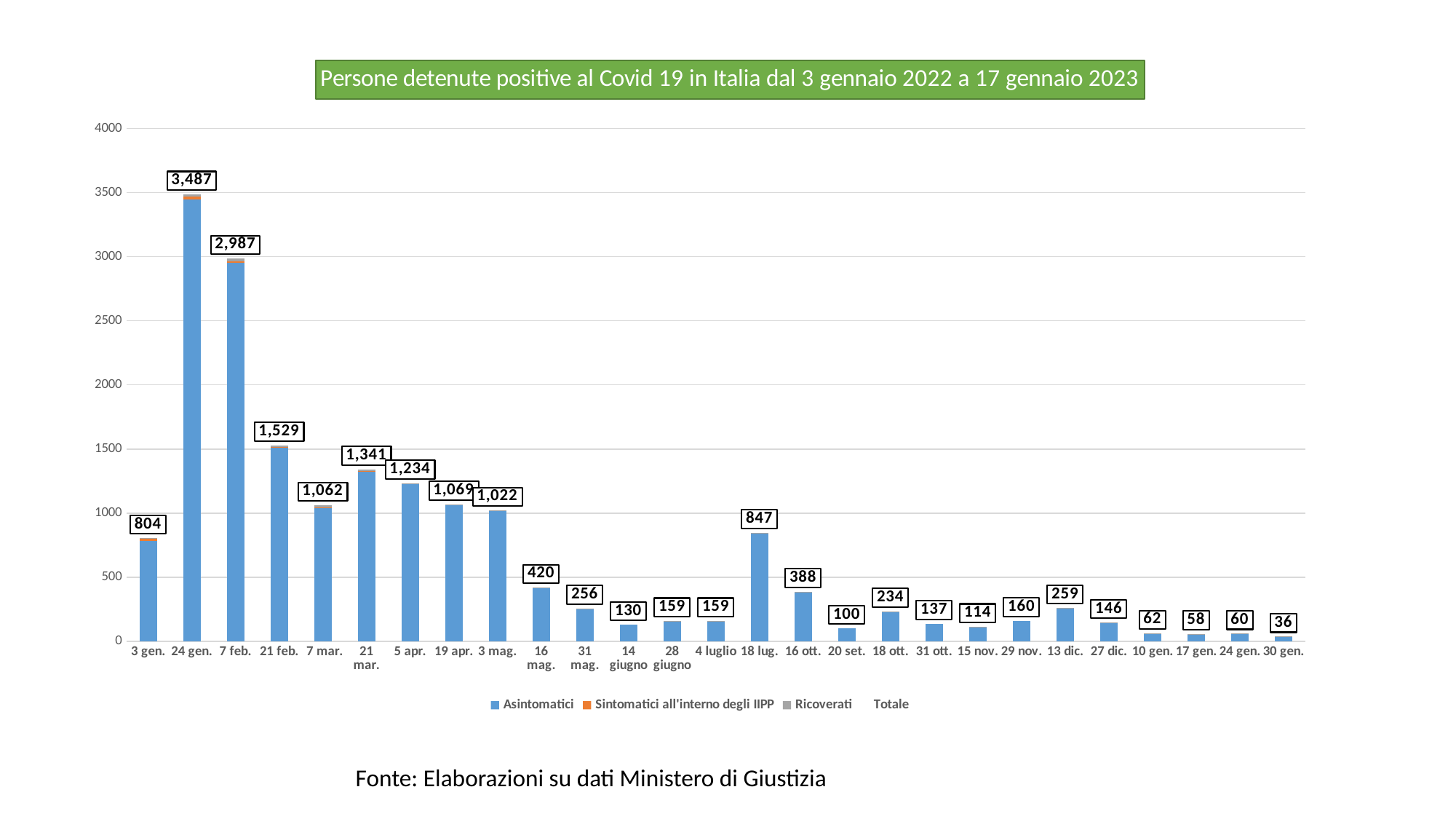
Which date has the lowest total on the chart? 30 gen. How many entries does the legend list? 4 Is the total for 5 apr. greater or less than 1500? less What is the difference between the totals for the second bar (24 gen., 3,487) and 7 feb.? 500 What is the difference between the totals for 16 mag. and 31 mag.? 164 How many dates (bars) are shown on the x axis? 27 What is the total number of positive detainees shown for 7 feb.? 2,987 What kind of chart is shown on the slide? bar chart What is the total value labelled for 20 set.? 100 What is the total value labelled for 18 lug.? 847 Which has a larger total, 16 ott. or 13 dic.? 16 ott. What is the highest total value shown on the chart? 3,487